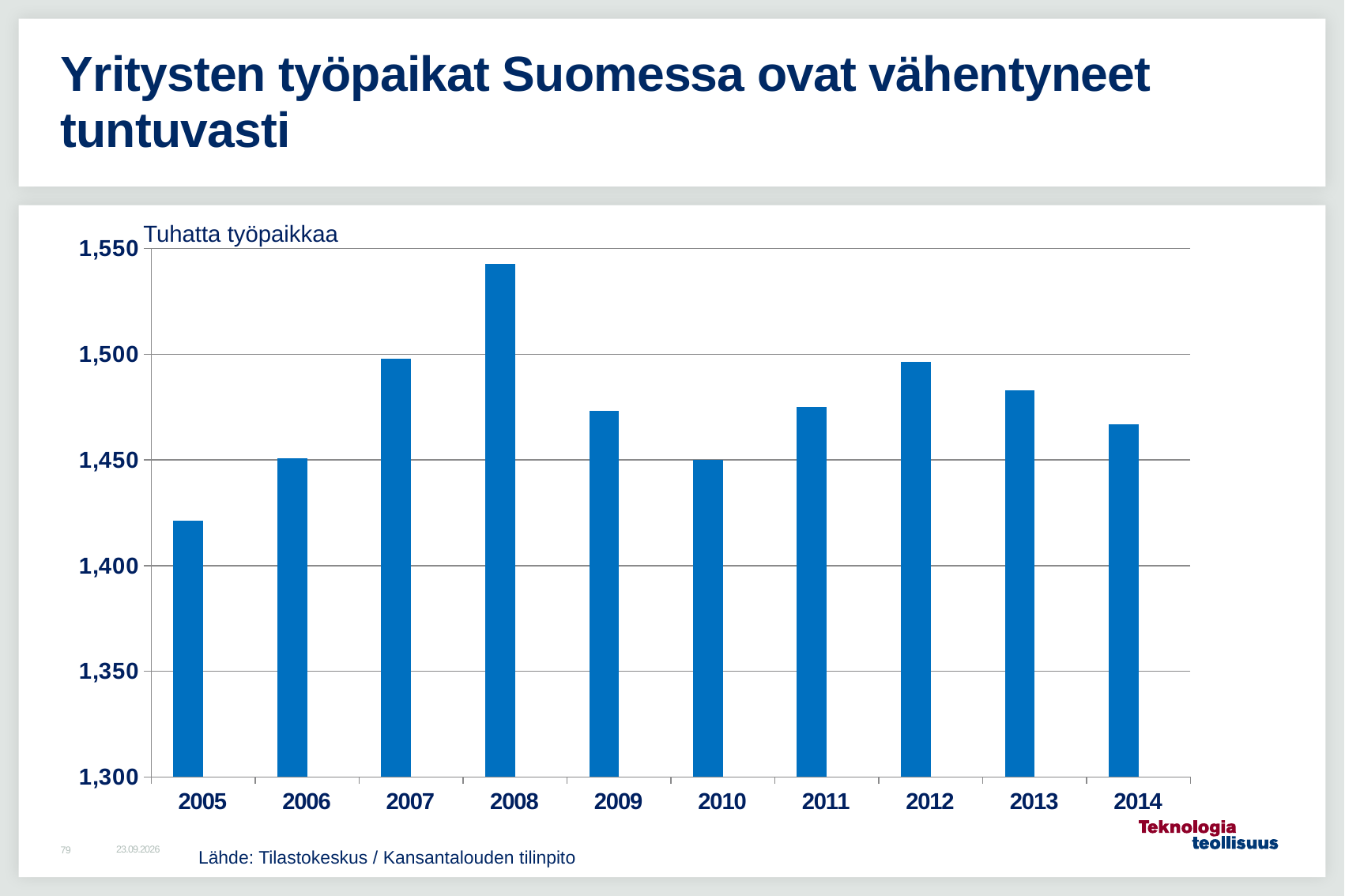
Is the value for 2014 greater or less than 1,450? greater Is the value for 2008 greater or less than 1,500? greater Do the values rise or fall from 2005 to 2008? rise What unit label is shown above the y axis of the chart? Tuhatta työpaikkaa Which year has a higher value, 2007 or 2009? 2007 What kind of chart is shown on the slide? Bar chart Is the value for 2005 greater or less than 1,400? greater Which year has the highest number of jobs in the chart? 2008 Which year has a higher value, 2012 or 2014? 2012 Which year has the lowest number of jobs in the chart? 2005 How many years are shown on the x axis of the chart? 10